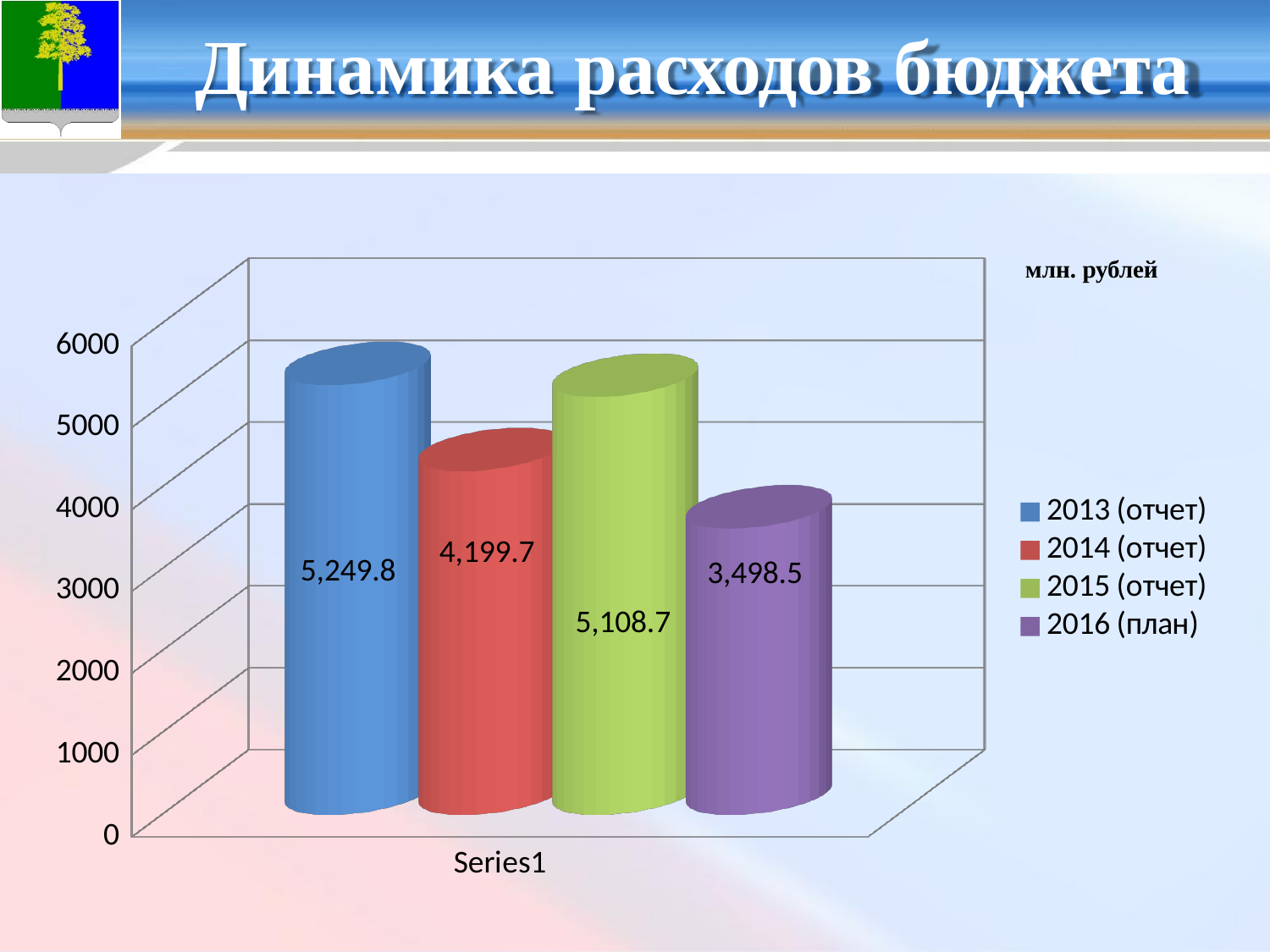
Which is larger, the value for 2014 (отчет) or the value for 2015 (отчет)? 2015 (отчет) What is the value for 2016 (план)? 3,498.5 Is the value for 2016 (план) greater or less than 4000? less Which year has the lowest value? 2016 (план) What is the value for 2014 (отчет)? 4,199.7 What unit is indicated for the values in the chart? млн. рублей What kind of chart is shown on the slide? bar chart How many entries does the legend list? 4 What is the difference between the values for 2013 (отчет) and 2016 (план)? 1,751.3 Which year has the highest value? 2013 (отчет) What is the value for 2013 (отчет)? 5,249.8 What is the value for 2015 (отчет)? 5,108.7